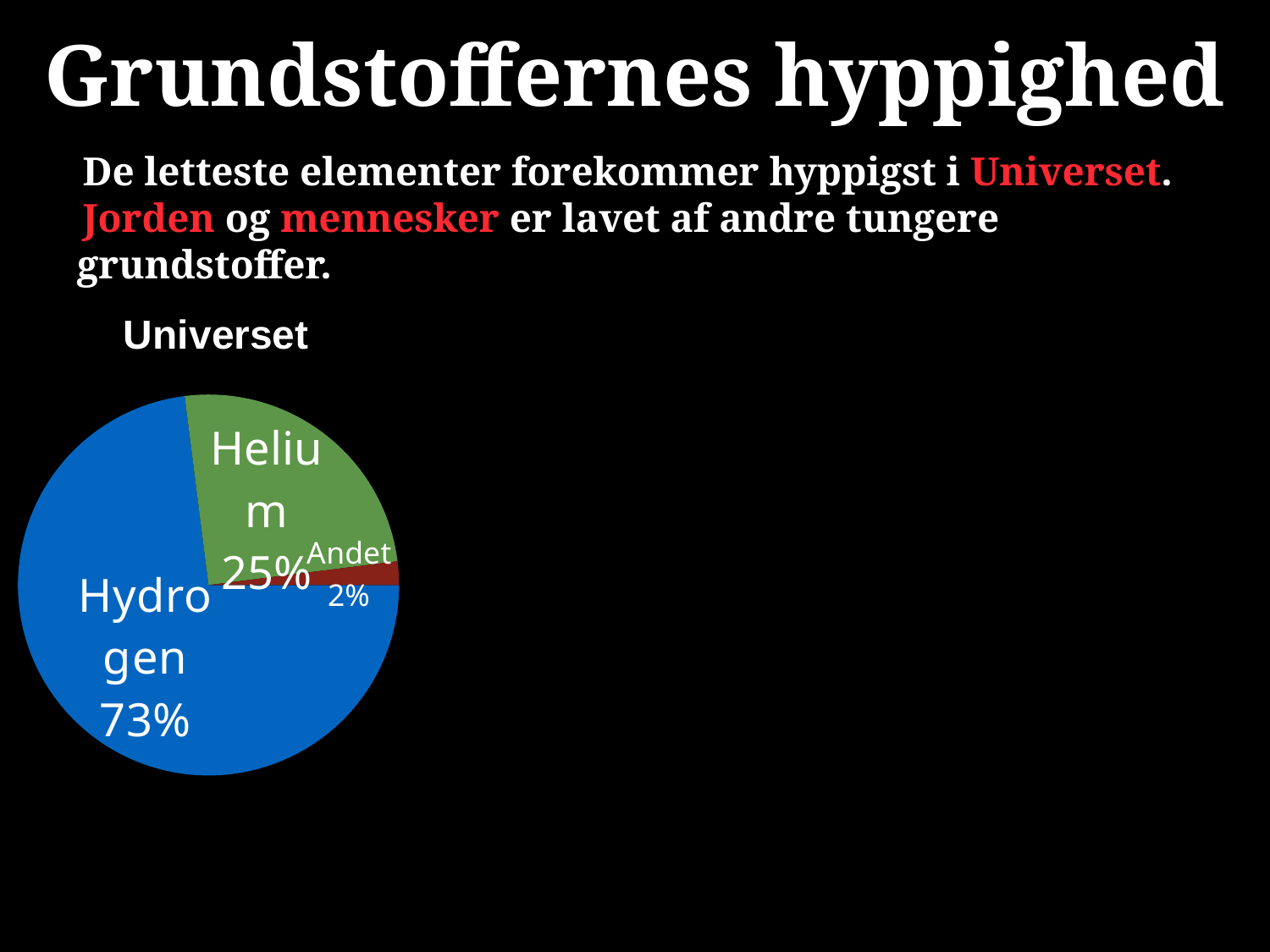
What is the difference in percentage points between Helium and Andet? 23 What is the difference in percentage points between Hydrogen and Helium? 48 What is the title of the pie chart? Universet What share of the pie does Hydrogen have? 73% Which is larger, the Helium slice or the Andet slice? Helium What kind of chart is shown on the slide? pie chart Which slice of the pie chart is the largest? Hydrogen How many slices does the pie chart have? 3 Which slice of the pie chart is the smallest? Andet What share of the pie does Andet have? 2% What share of the pie does Helium have? 25% What colour is the Hydrogen slice? blue